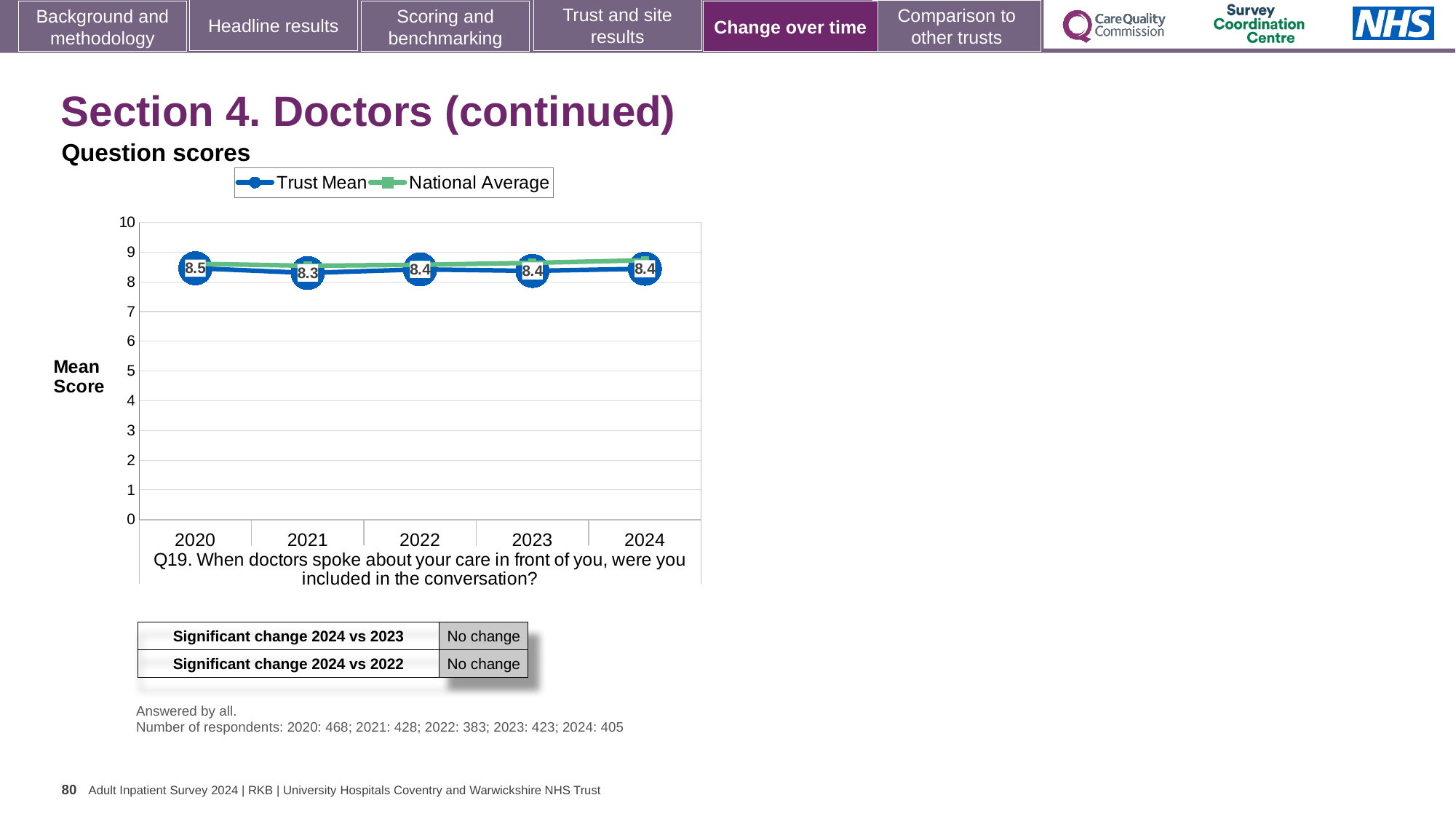
Is the National Average value for 2024 greater or less than 8? greater How many series does the chart legend list? 2 What is the Trust Mean score for 2024? 8.4 Which year has the larger Trust Mean score, 2020 or 2021? 2020 Did the Trust Mean score rise or fall from 2020 to 2021? fall What kind of chart is shown on the slide? line chart What is the Trust Mean score for 2021? 8.3 What is the difference between the Trust Mean scores for 2020 and 2021? 0.2 How many years are shown on the x axis of the chart? 5 In which year is the Trust Mean score highest? 2020 What is the Trust Mean score for 2020? 8.5 In which year is the Trust Mean score lowest? 2021